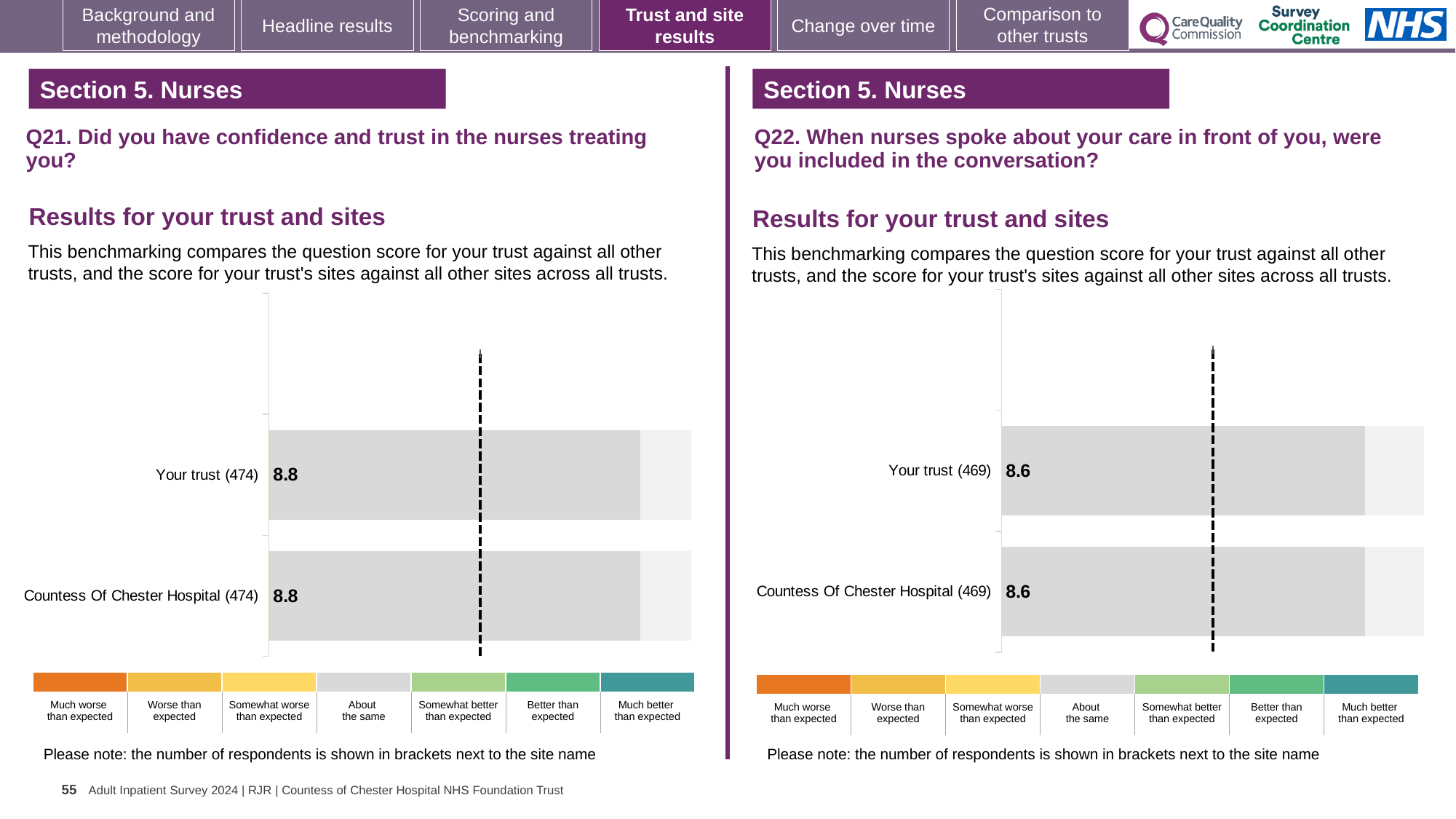
On the Q21 chart (left), how many respondents are shown in brackets for Your trust? 474 How many bars are plotted on the Q21 chart (left)? 2 On the Q22 chart (right), what is the difference between the score for Your trust and the score for Countess Of Chester Hospital? 0 On the Q21 chart (left), what is the score for Your trust? 8.8 Is the score for Your trust on the Q21 chart (left) larger or smaller than the score for Your trust on the Q22 chart (right)? Larger On the Q22 chart (right), what is the score for Your trust? 8.6 On the Q21 chart (left), what is the score for Countess Of Chester Hospital? 8.8 What kind of chart is used on the Q22 chart (right)? Bar chart On the Q22 chart (right), how many respondents are shown in brackets for Countess Of Chester Hospital? 469 How many bars are plotted on the Q22 chart (right)? 2 On the Q22 chart (right), what is the score for Countess Of Chester Hospital? 8.6 On the Q21 chart (left), what is the difference between the score for Your trust and the score for Countess Of Chester Hospital? 0